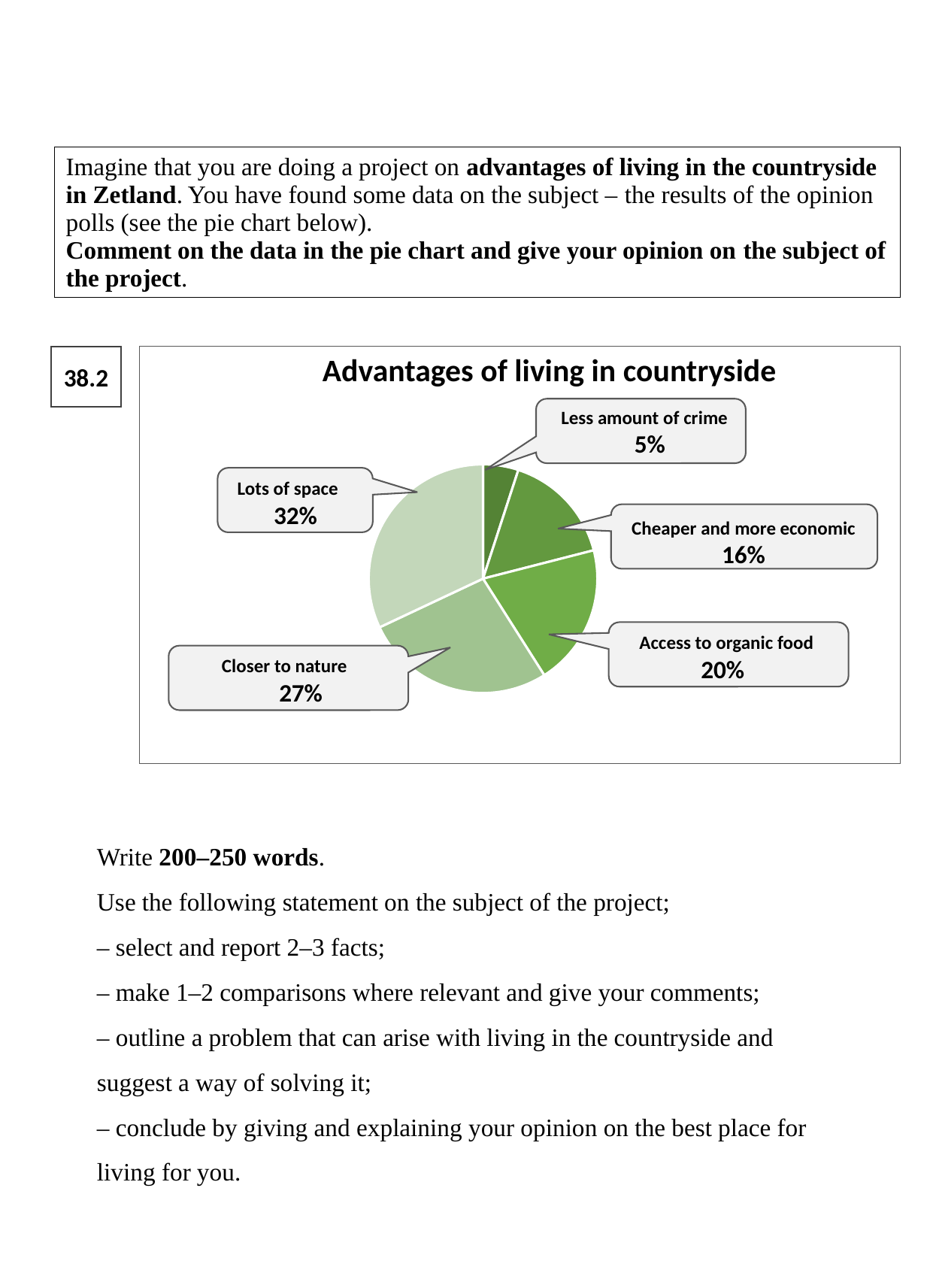
What is the value shown for 'Less amount of crime'? 5% Which advantage has the smallest share of the pie chart? Less amount of crime Which is larger: the share for 'Closer to nature' or the share for 'Cheaper and more economic'? Closer to nature What percentage is given for 'Cheaper and more economic'? 16% What is the difference in percentage points between 'Lots of space' and 'Closer to nature'? 5 What share does 'Access to organic food' have in the pie chart? 20% How many categories are shown in the pie chart? 5 What is the title of the chart? Advantages of living in countryside What percentage of respondents chose 'Lots of space' as an advantage of living in the countryside? 32% What is the difference in percentage points between 'Access to organic food' and 'Less amount of crime'? 15 Which advantage has the largest share of the pie chart? Lots of space What type of chart is shown on the slide? Pie chart